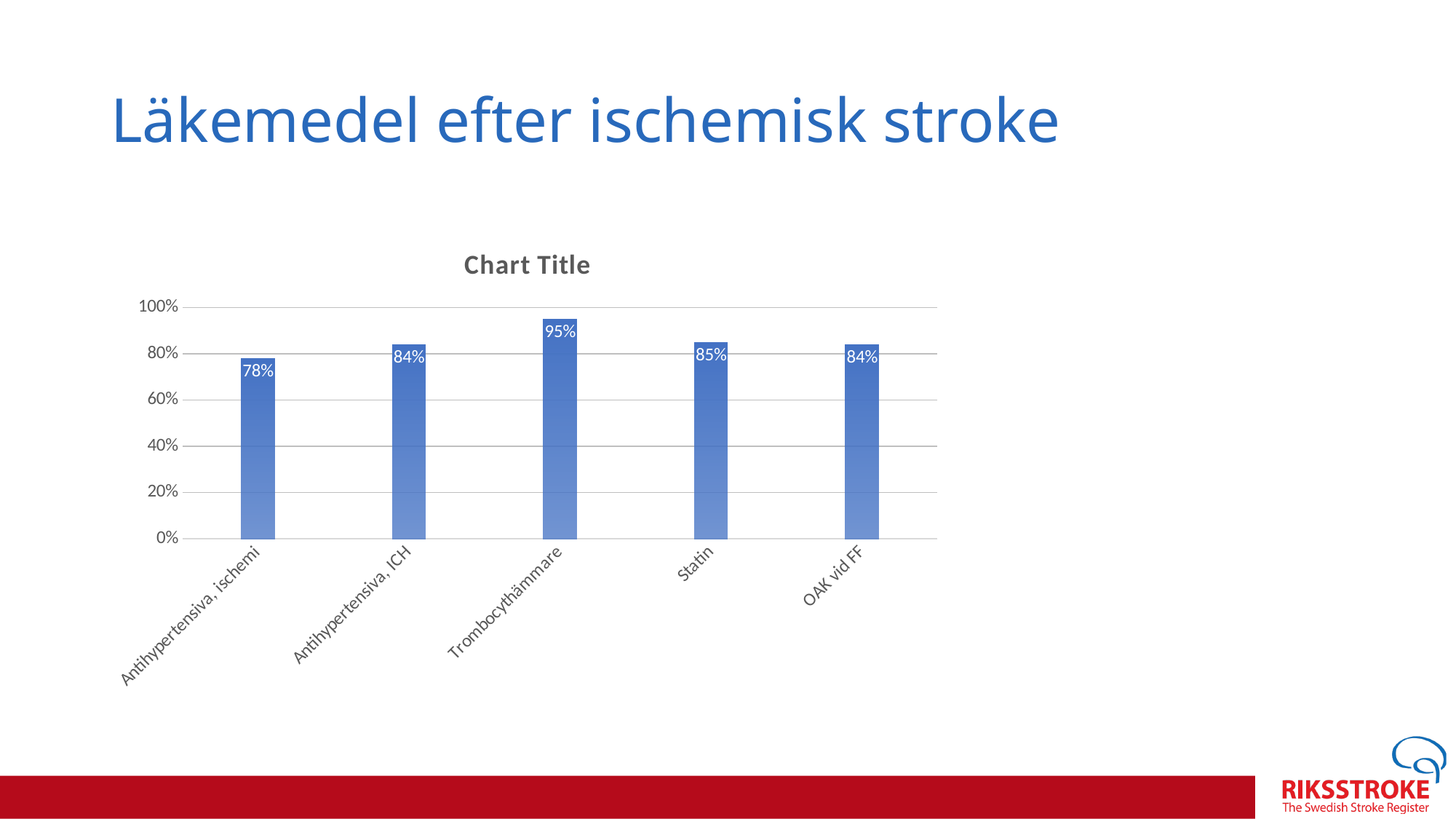
What is the value for Statin? 85% What is the value for OAK vid FF? 84% What is the title shown above the chart? Chart Title Which category has the highest value? Trombocythämmare What is the difference between the values for Trombocythämmare and Antihypertensiva, ischemi? 17% What kind of chart is shown on the slide? Bar chart Which category has the lowest value? Antihypertensiva, ischemi What is the difference between the values for Statin and Antihypertensiva, ICH? 1% Which is larger, the value for Trombocythämmare or the value for Statin? Trombocythämmare How many categories are shown on the x axis? 5 What is the value for Antihypertensiva, ischemi? 78% What is the value for Trombocythämmare? 95%